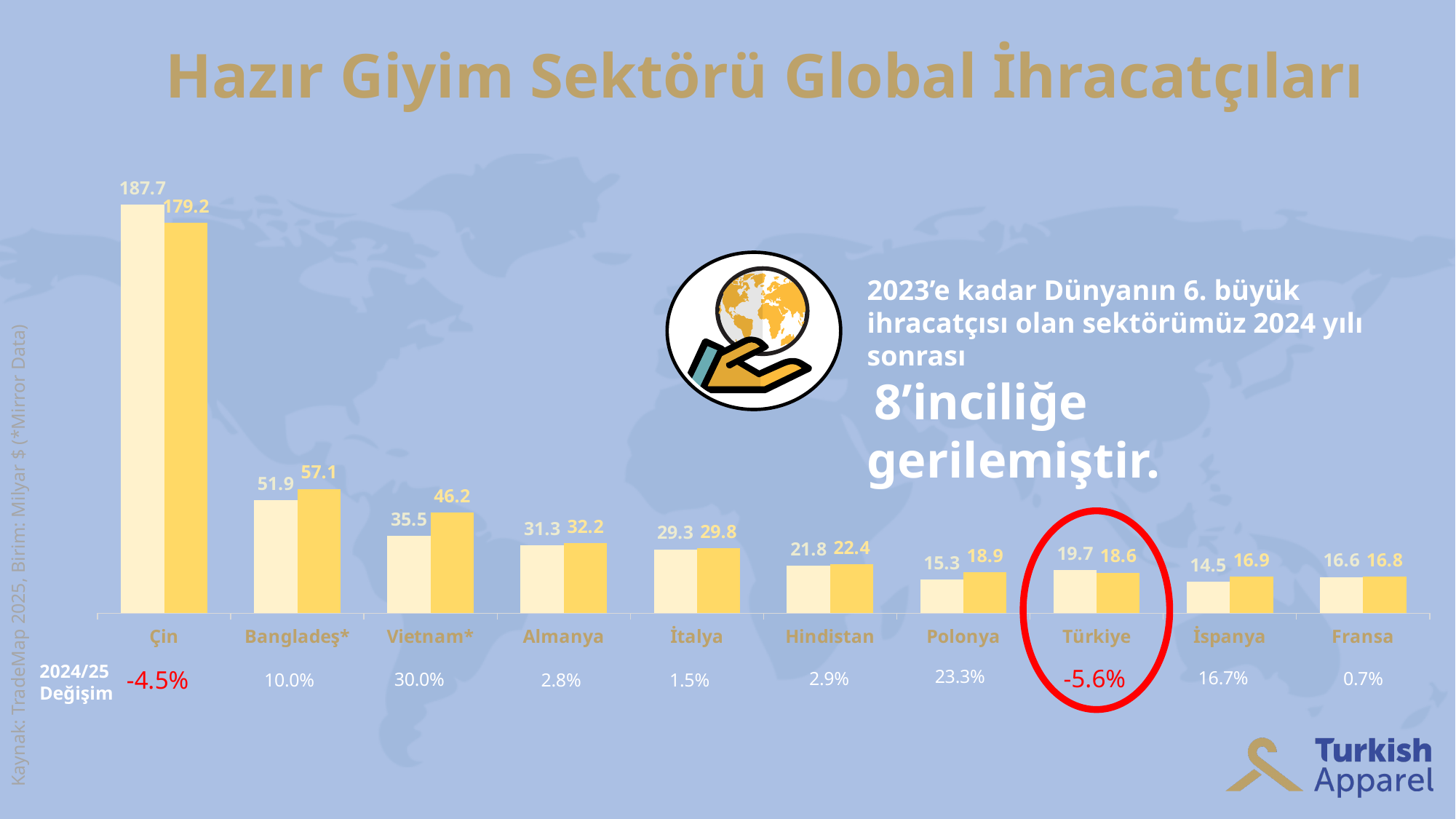
What is the 2024/25 Değişim value shown for Türkiye? -5.6% Which country has the highest 2024/25 Değişim value? Vietnam* What is the value of the first (lighter) bar for Çin? 187.7 What is the value of the second (darker) bar for Türkiye? 18.6 Which country has the highest bars in the chart? Çin How many countries are shown on the x axis of the chart? 10 What is the difference between the two bars for Çin (187.7 and 179.2)? 8.5 What is the difference between the two bars for Bangladeş* (57.1 and 51.9)? 5.2 What kind of chart is shown on the slide? Bar chart What is the value of the second bar for Vietnam*? 46.2 Which is larger: the second bar for Vietnam* or the second bar for Almanya? Vietnam* What is the title of the chart on the slide? Hazır Giyim Sektörü Global İhracatçıları